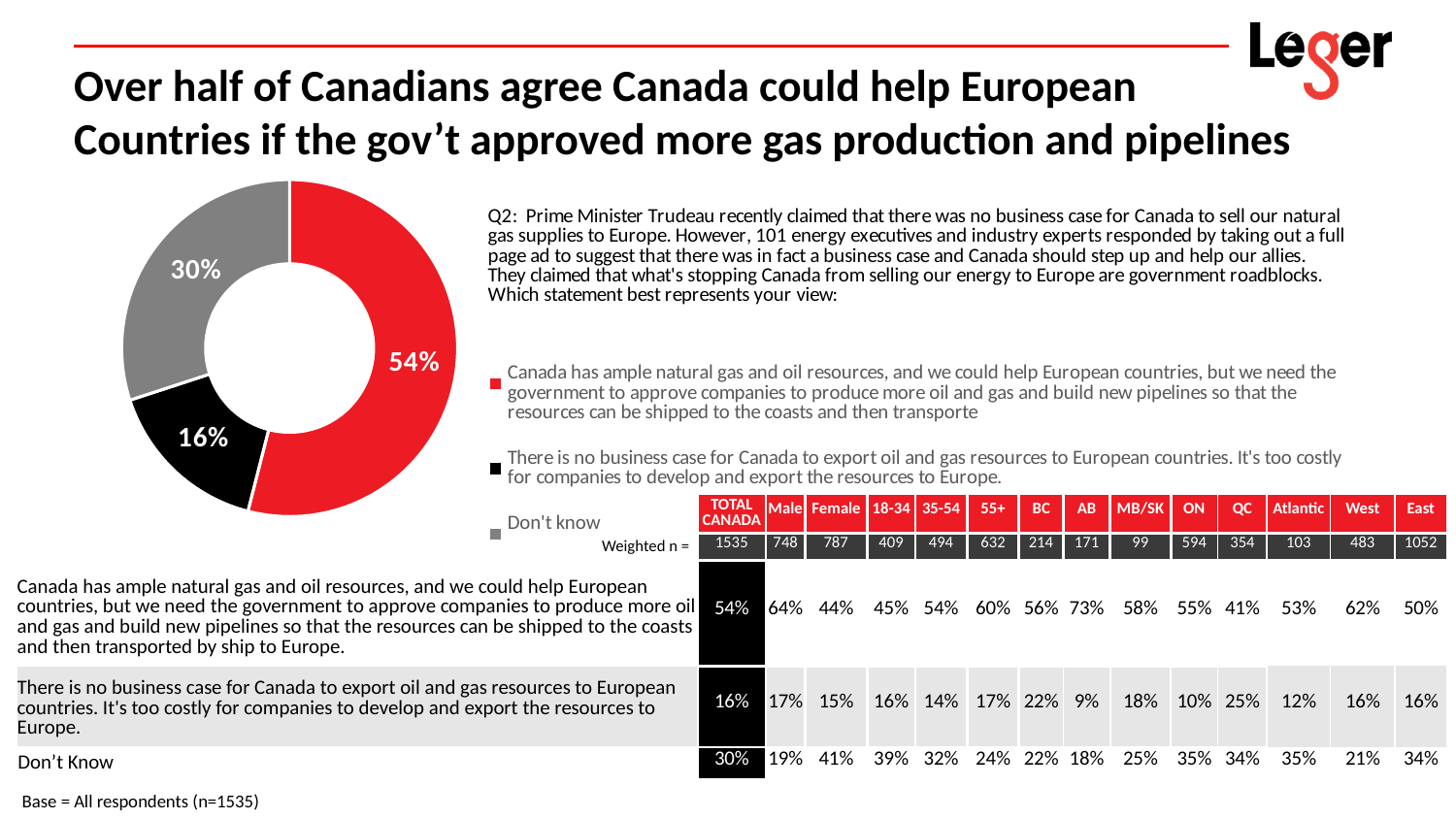
What share of respondents chose the statement that Canada has ample natural gas and oil resources and could help European countries? 54% How many slices does the pie chart have? 3 What colour is the 54% slice in the pie chart? Red What share of respondents answered 'Don't know'? 30% What colour is the slice representing 'Don't know' in the pie chart? Grey Which response has the largest slice of the pie chart? Canada has ample natural gas and oil resources, and we could help European countries What is the difference in percentage points between the 'ample natural gas' slice and the 'Don't know' slice? 24 percentage points What share of respondents chose the statement that there is no business case for Canada to export oil and gas to European countries? 16% Which response has the smallest slice of the pie chart? There is no business case for Canada to export oil and gas resources to European countries How many entries does the legend of the pie chart list? 3 Which is larger in the pie chart: the 'Don't know' slice or the 'no business case' slice? Don't know What kind of chart is shown on the slide? Pie chart (donut)